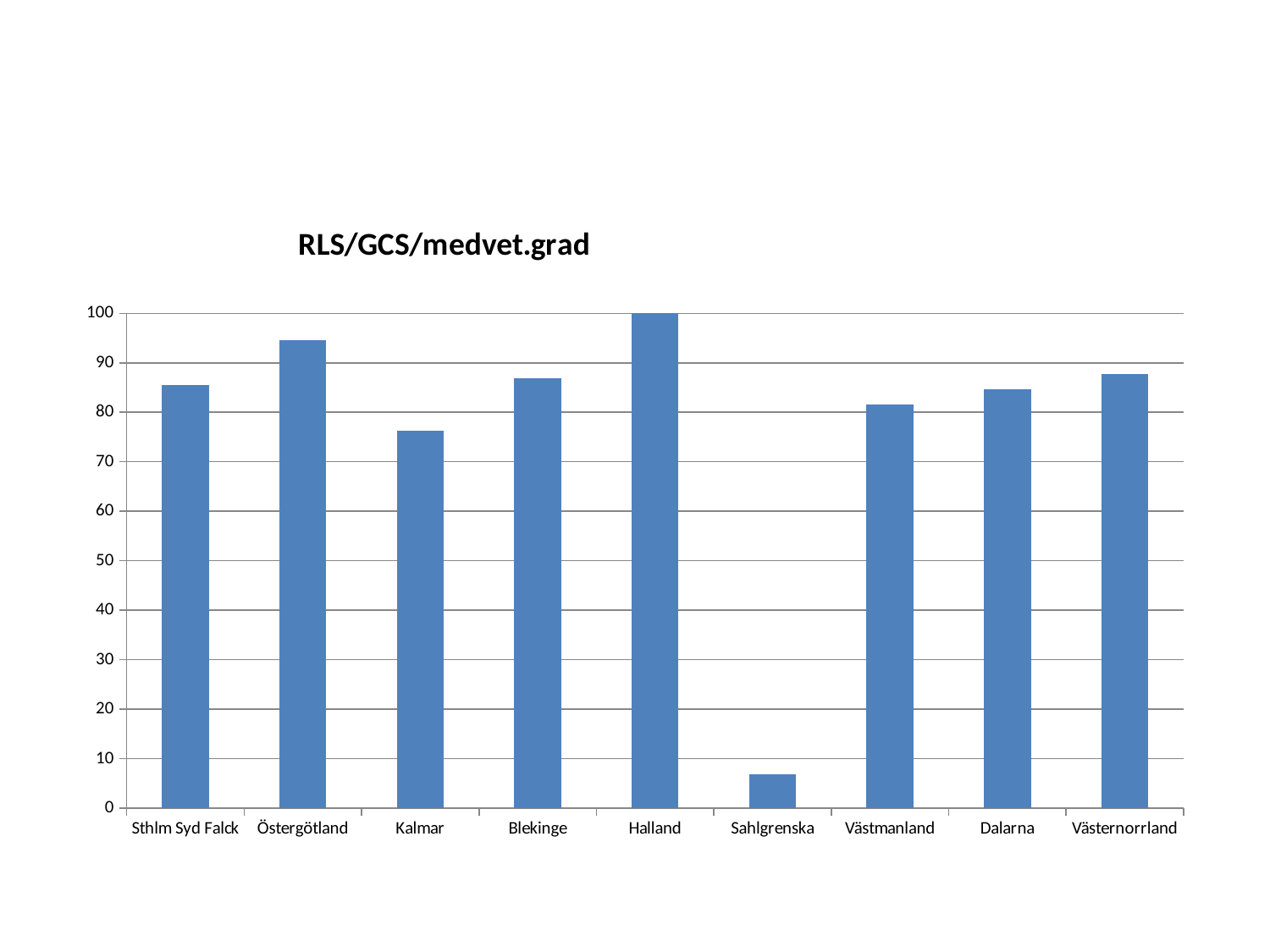
Is the value for Kalmar greater or less than 80? less Is the value for Västmanland greater or less than 80? greater What kind of chart is shown on the slide? bar chart Which is larger, the value for Kalmar or the value for Västmanland? Västmanland What is the title of the chart? RLS/GCS/medvet.grad Which category has the lowest value in the chart? Sahlgrenska How many categories are shown on the x axis of the chart? 9 Which category has the highest value in the chart? Halland What is the value for Halland? 100 Is the value for Sahlgrenska greater or less than 10? less Which is larger, the value for Östergötland or the value for Kalmar? Östergötland